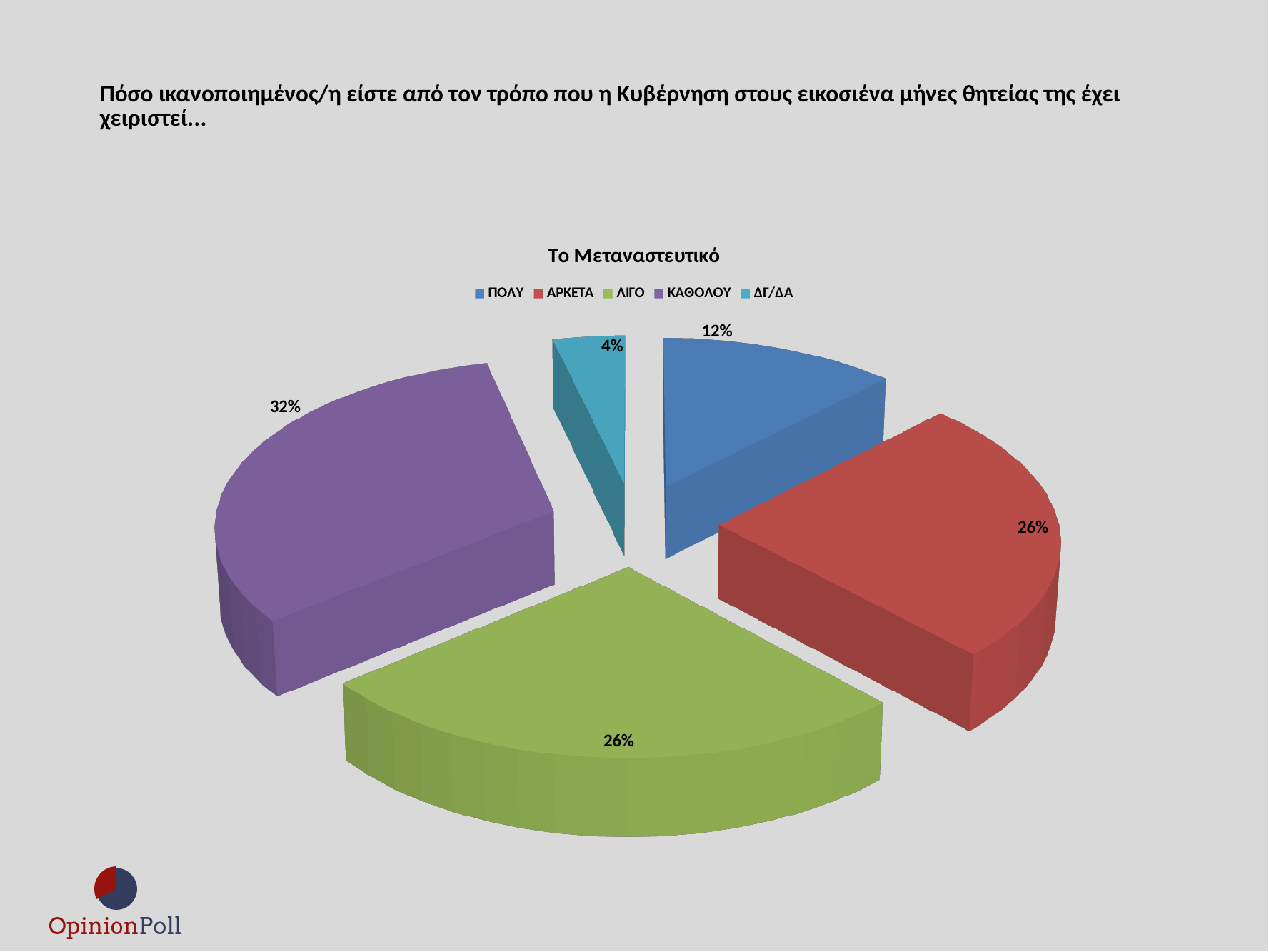
What share of the pie does ΠΟΛΥ hold? 12% What is the difference in percentage points between ΚΑΘΟΛΟΥ and ΠΟΛΥ? 20 Which category has the smallest slice? ΔΓ/ΔΑ Which category has the largest slice? ΚΑΘΟΛΟΥ Which is larger, the slice for ΛΙΓΟ or the slice for ΠΟΛΥ? ΛΙΓΟ What share of the pie does ΚΑΘΟΛΟΥ hold? 32% What colour is the slice for ΚΑΘΟΛΟΥ? purple How many categories does the legend list? 5 What is the chart's title? Το Μεταναστευτικό What share of the pie does ΔΓ/ΔΑ hold? 4% What type of chart is shown on the slide? pie chart What share of the pie does ΑΡΚΕΤΑ hold? 26%